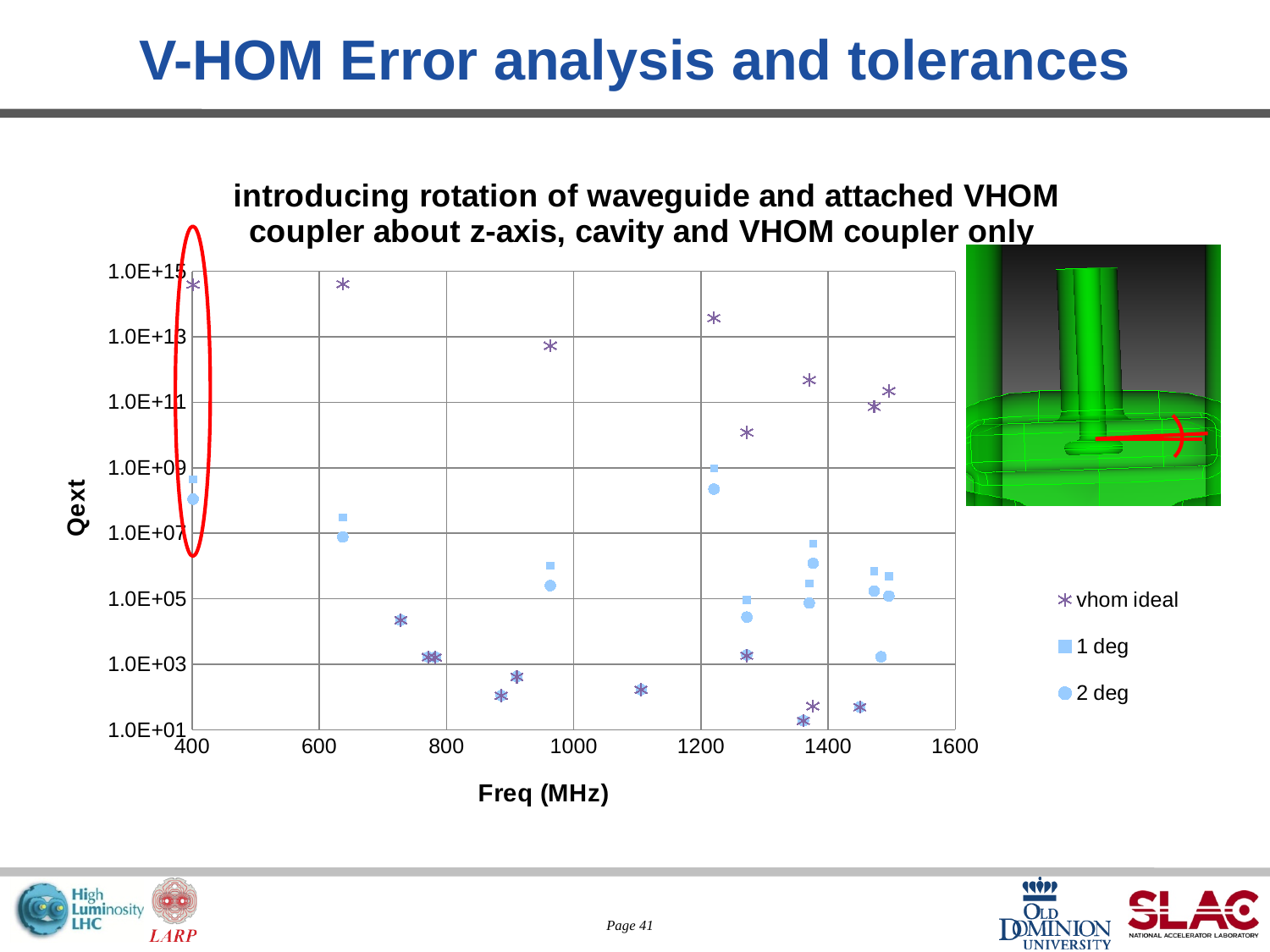
How many series does the legend list? 3 Is the vhom ideal value at about 1110 MHz greater or less than 1.0E+03? less What is the label on the vertical axis? Qext Is the 2 deg value at about 1220 MHz greater or less than 1.0E+09? less What are the three series named in the legend? vhom ideal, 1 deg, 2 deg Is the 2 deg value at about 1460 MHz greater or less than 1.0E+07? less What kind of chart is shown on the slide? scatter chart At about 1220 MHz, which series has the larger Qext value, vhom ideal or 2 deg? vhom ideal Which series reaches the highest Qext values on the chart? vhom ideal